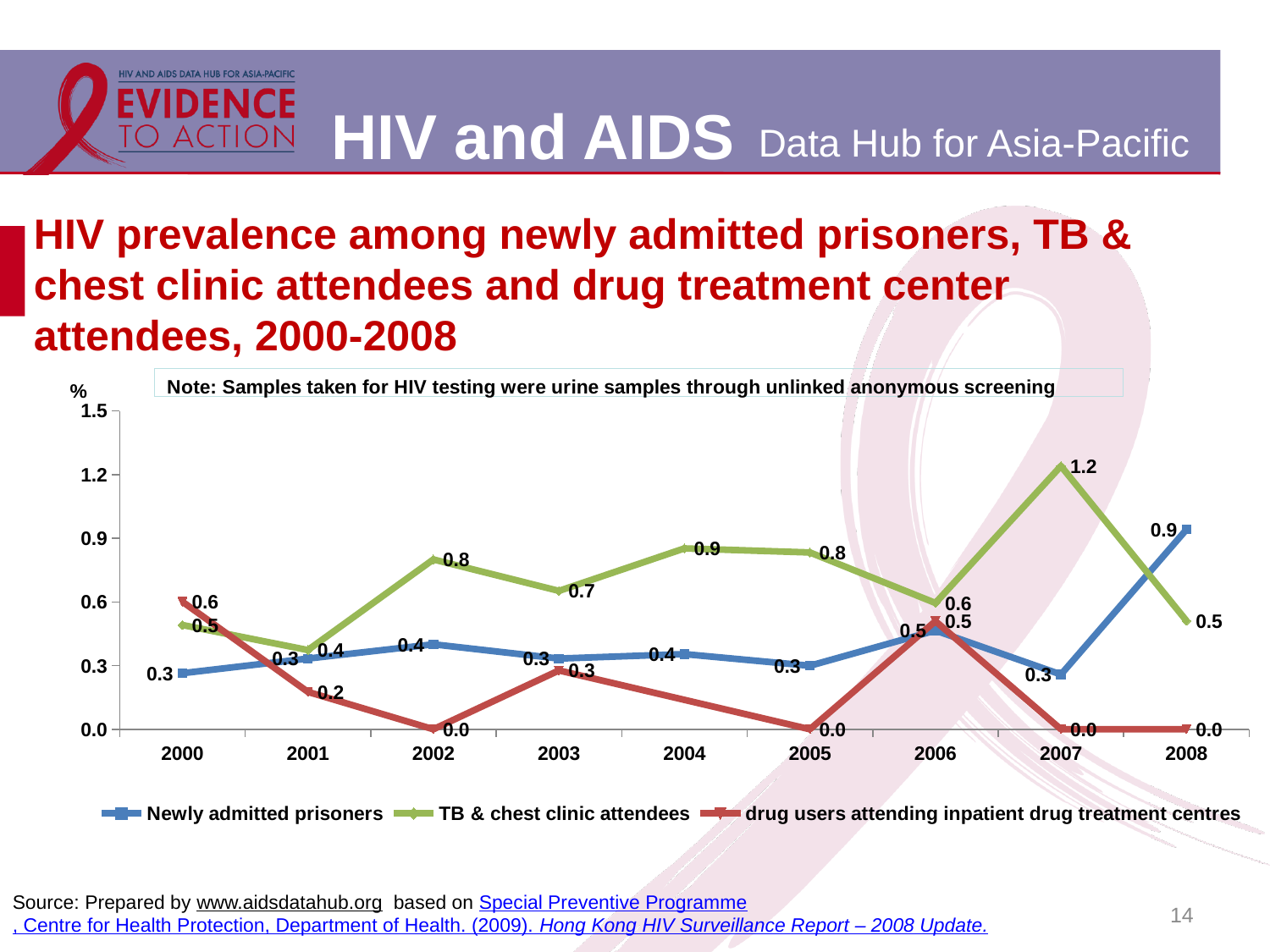
In 2004, which series has the higher value: newly admitted prisoners or TB & chest clinic attendees? TB & chest clinic attendees What is the HIV prevalence among TB & chest clinic attendees in 2007? 1.2 In which year is the HIV prevalence among newly admitted prisoners highest? 2008 What is the HIV prevalence among drug users attending inpatient drug treatment centres in 2000? 0.6 Which colour is used for the drug users attending inpatient drug treatment centres series? Red What kind of chart is shown on the slide? Line chart In which year is the HIV prevalence among TB & chest clinic attendees highest? 2007 How many series does the legend list? 3 Is the value for TB & chest clinic attendees in 2007 greater or less than 0.9? greater What is the difference between the TB & chest clinic attendees value in 2007 and the newly admitted prisoners value in 2007? 0.9 How many years are shown on the x axis? 9 What is the HIV prevalence among newly admitted prisoners in 2008? 0.9